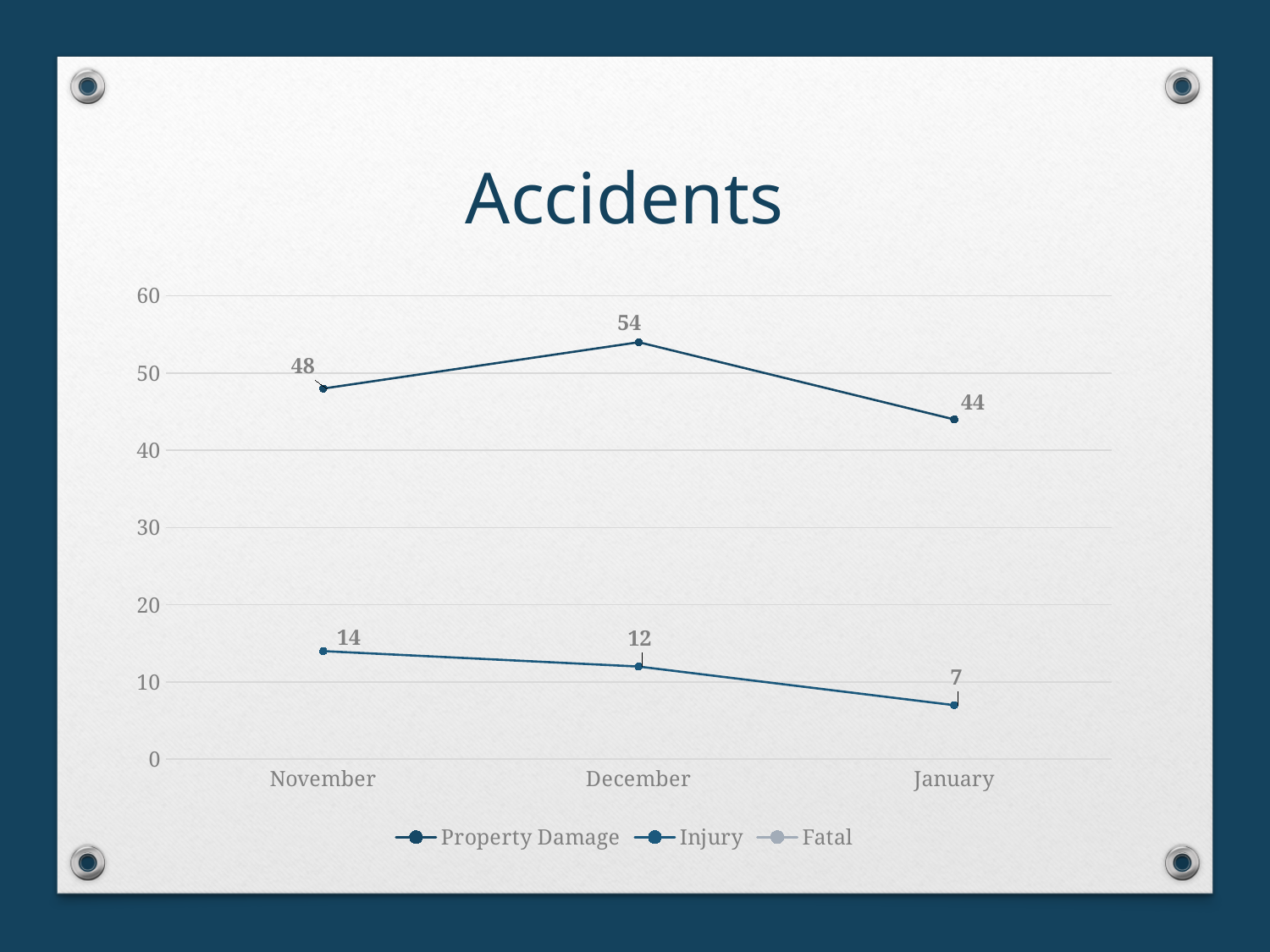
How many series does the legend of the Accidents chart list? 3 Does the lower line rise or fall from November to January on the Accidents chart? fall What is the value of the upper line in December on the Accidents chart? 54 What is the value of the lower line in December on the Accidents chart? 12 What is the title of the chart on the slide? Accidents In which month does the lower line reach its lowest value on the Accidents chart? January How many months are shown on the x axis of the Accidents chart? 3 What is the value of the upper line in November on the Accidents chart? 48 What is the difference between the upper line's December value and its January value on the Accidents chart? 10 What kind of chart is shown on the Accidents slide? line chart What is the value of the lower line in January on the Accidents chart? 7 In which month does the upper line reach its highest value on the Accidents chart? December